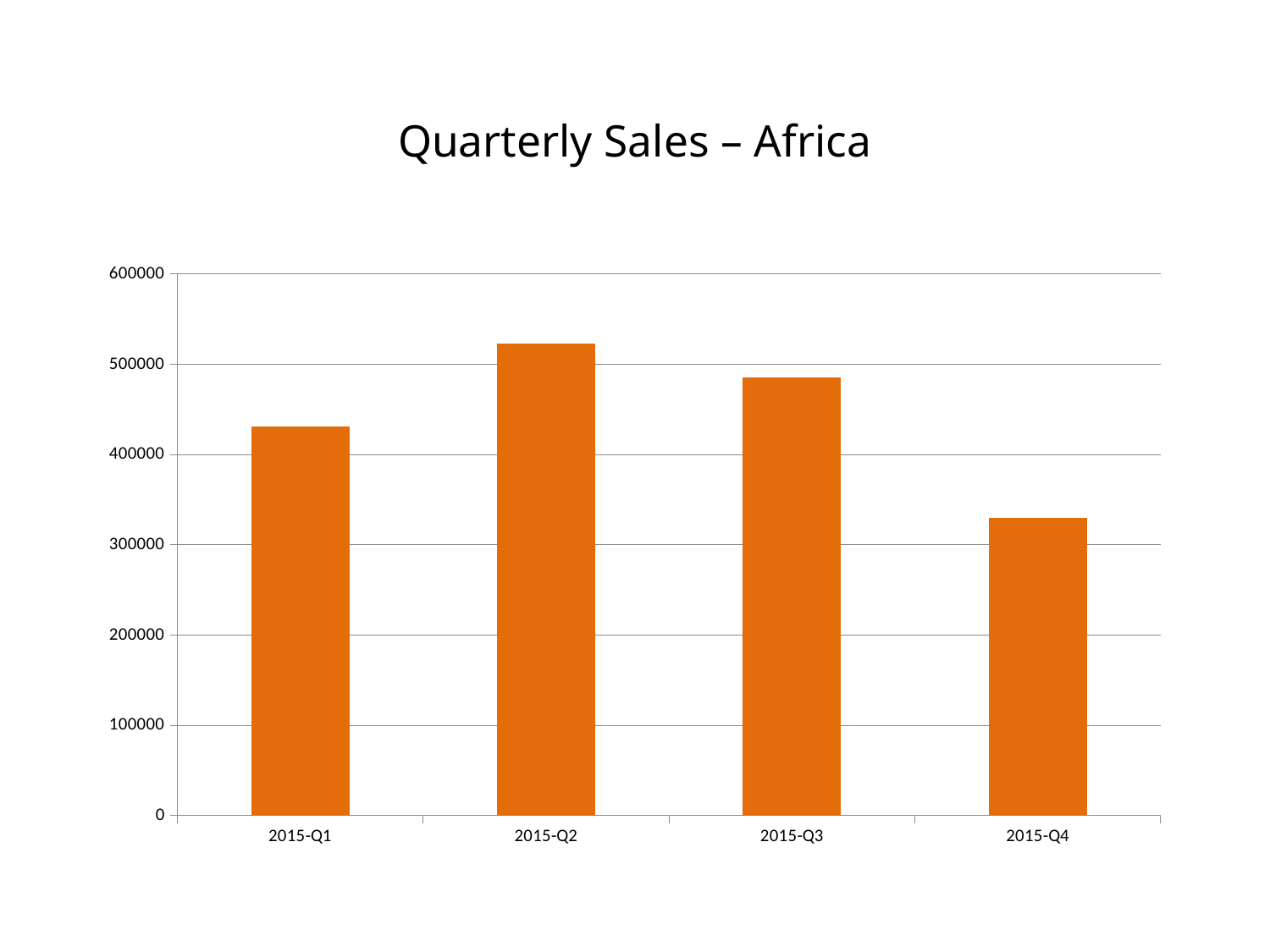
Which quarter has the lowest sales? 2015-Q4 Which is larger, the value for 2015-Q2 or 2015-Q3? 2015-Q2 Is the value for 2015-Q2 greater or less than 500000? greater Is the value for 2015-Q1 greater or less than 400000? greater Which is larger, the value for 2015-Q1 or 2015-Q3? 2015-Q3 What is the title of the chart? Quarterly Sales – Africa What kind of chart is shown on the slide? Bar chart Do the values rise or fall from 2015-Q2 to 2015-Q4? fall Is the value for 2015-Q4 greater or less than 300000? greater Which quarter has the highest sales? 2015-Q2 How many quarters are plotted on the chart? 4